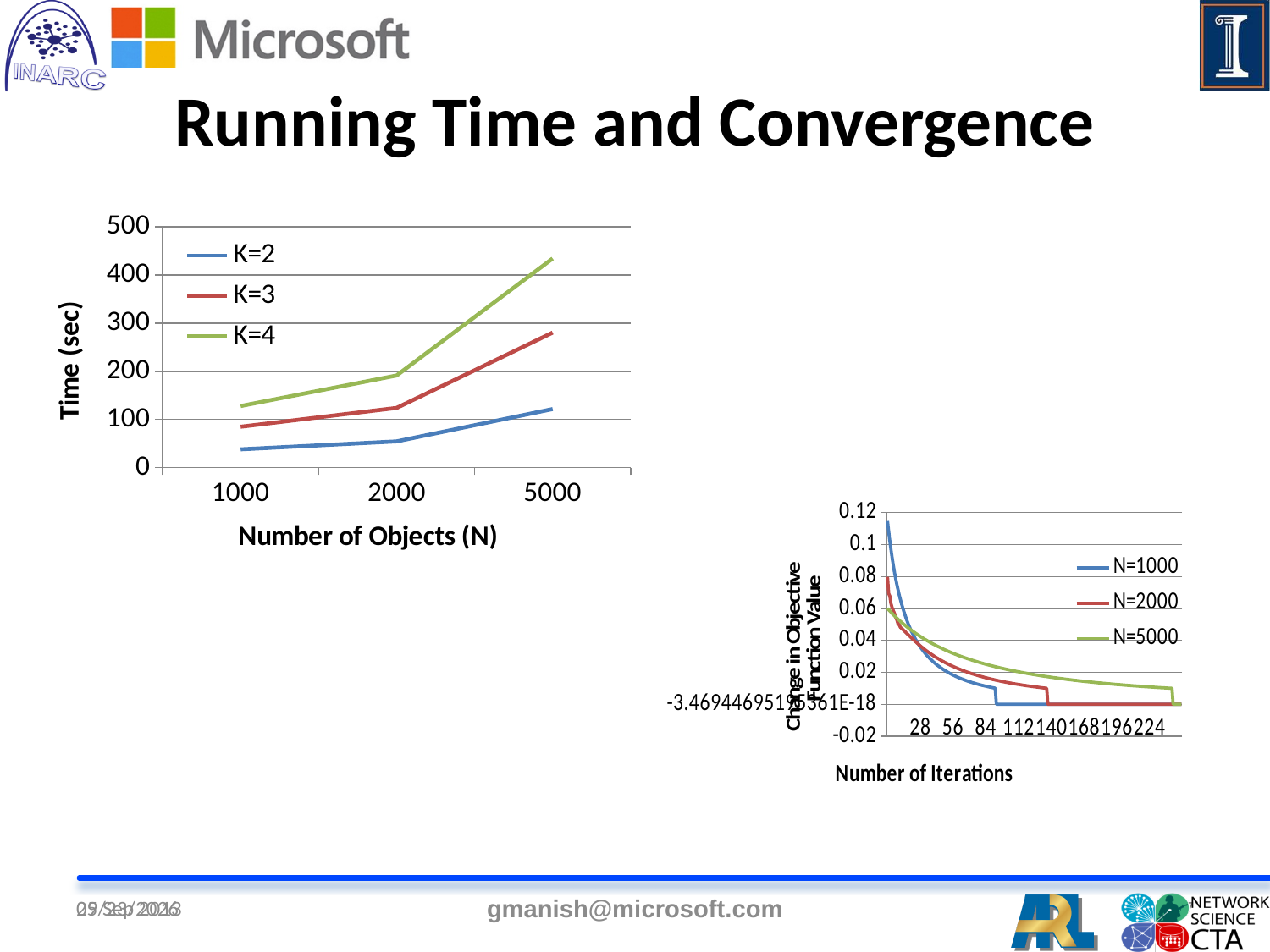
In the left chart, is the time for K=4 at N=5000 greater or less than 400? greater What kind of chart is the left chart, with Time (sec) on the y axis? line chart How many series does the legend of the left chart (Time vs Number of Objects) list? 3 How many series does the legend of the right chart (Number of Iterations on the x axis) list? 3 In the left chart, which is larger at N=2000: the time for K=3 or the time for K=2? K=3 How many values of Number of Objects (N) are shown on the x axis of the left chart? 3 In the left chart, does the time for K=4 rise or fall as the Number of Objects increases? rise In the right chart, is the starting value of the N=1000 series greater or less than 0.1? greater In the right chart, does the Change in Objective Function Value for N=5000 rise or fall as the Number of Iterations increases? fall What is the x-axis title of the left chart? Number of Objects (N) In the left chart (Time vs Number of Objects), which series has the highest time at N=5000? K=4 In the left chart, is the time for K=2 at N=1000 greater or less than 100? less